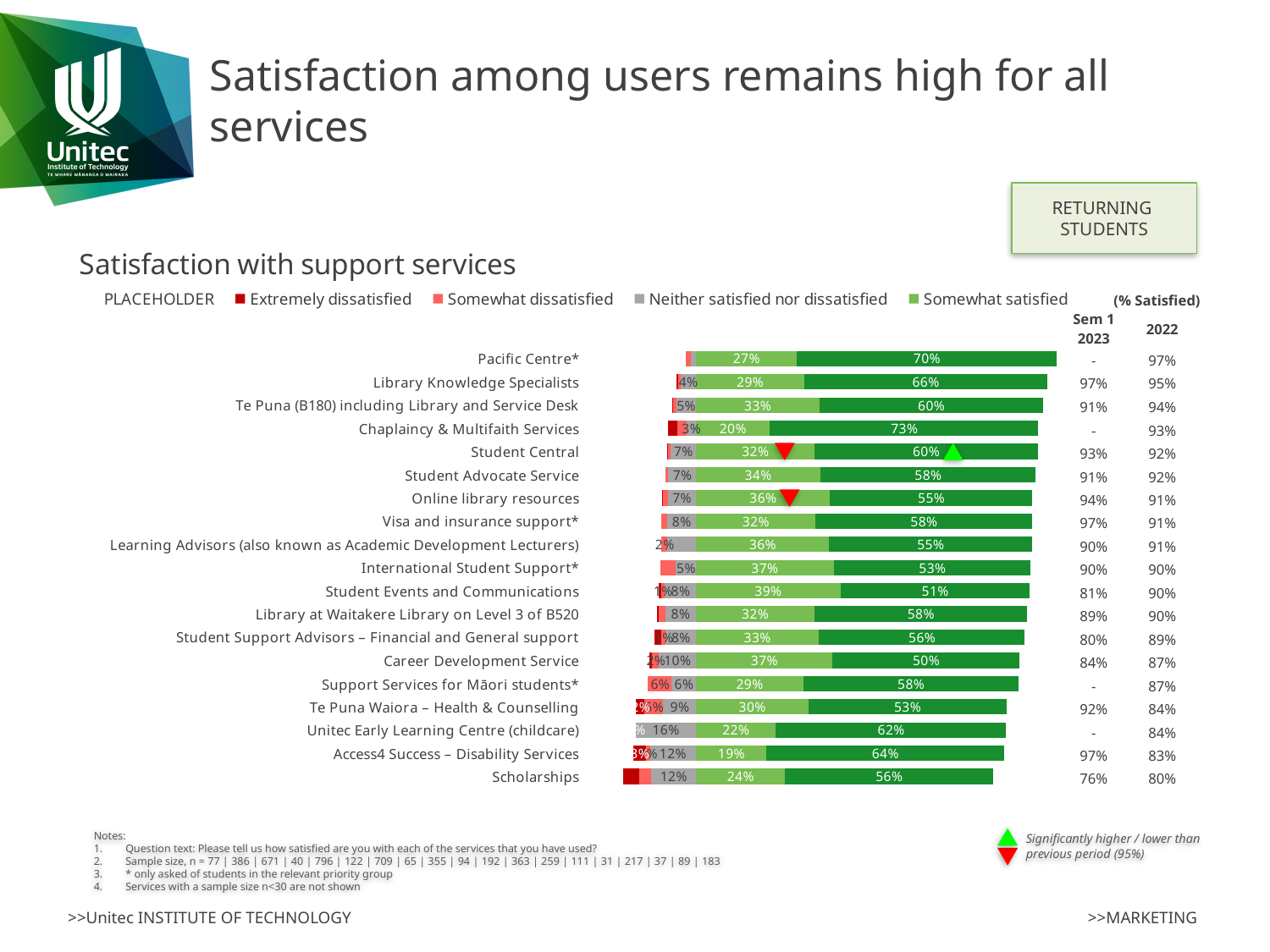
What kind of chart is shown on the slide? bar chart What is the title of the chart? Satisfaction with support services What is the 2022 % Satisfied value for Scholarships? 80% What is the difference between the dark green segment for Pacific Centre* and the dark green segment for Scholarships? 14 percentage points How many services are listed in the chart? 19 Which service has the largest dark green segment? Chaplaincy & Multifaith Services Which service has the smallest dark green segment? Career Development Service What is the Sem 1 2023 % Satisfied value for Student Central? 93% What is the value of the dark green segment for Chaplaincy & Multifaith Services? 73% Which has a larger dark green segment: Online library resources or Visa and insurance support*? Visa and insurance support* What is the Neither satisfied nor dissatisfied value for Unitec Early Learning Centre (childcare)? 16% What is the Somewhat satisfied value for Student Events and Communications? 39%